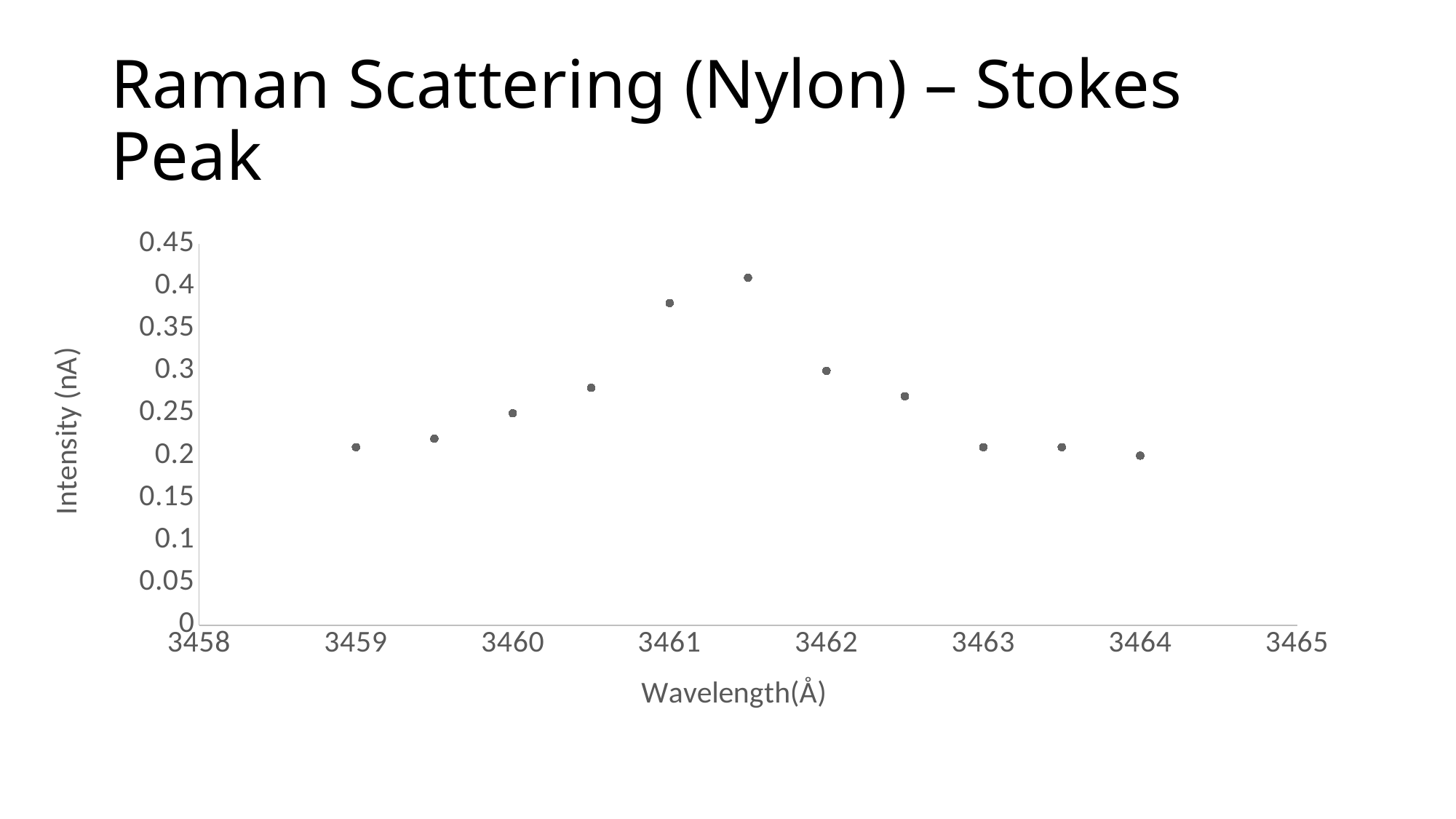
Is the intensity at wavelength 3464 greater or less than 0.25? less Is the intensity at wavelength 3460.5 greater or less than 0.25? greater What kind of chart is shown on the slide? scatter chart Is the intensity at wavelength 3461.5 greater or less than 0.4? greater Which has the higher intensity, wavelength 3460 or wavelength 3463? 3460 How many data points are plotted on the chart? 11 Which has the higher intensity, wavelength 3461 or wavelength 3462? 3461 At which wavelength is the intensity highest? 3461.5 How does the intensity change as wavelength increases from 3459 to 3464? rises to a peak then falls What is the label of the y axis? Intensity (nA)